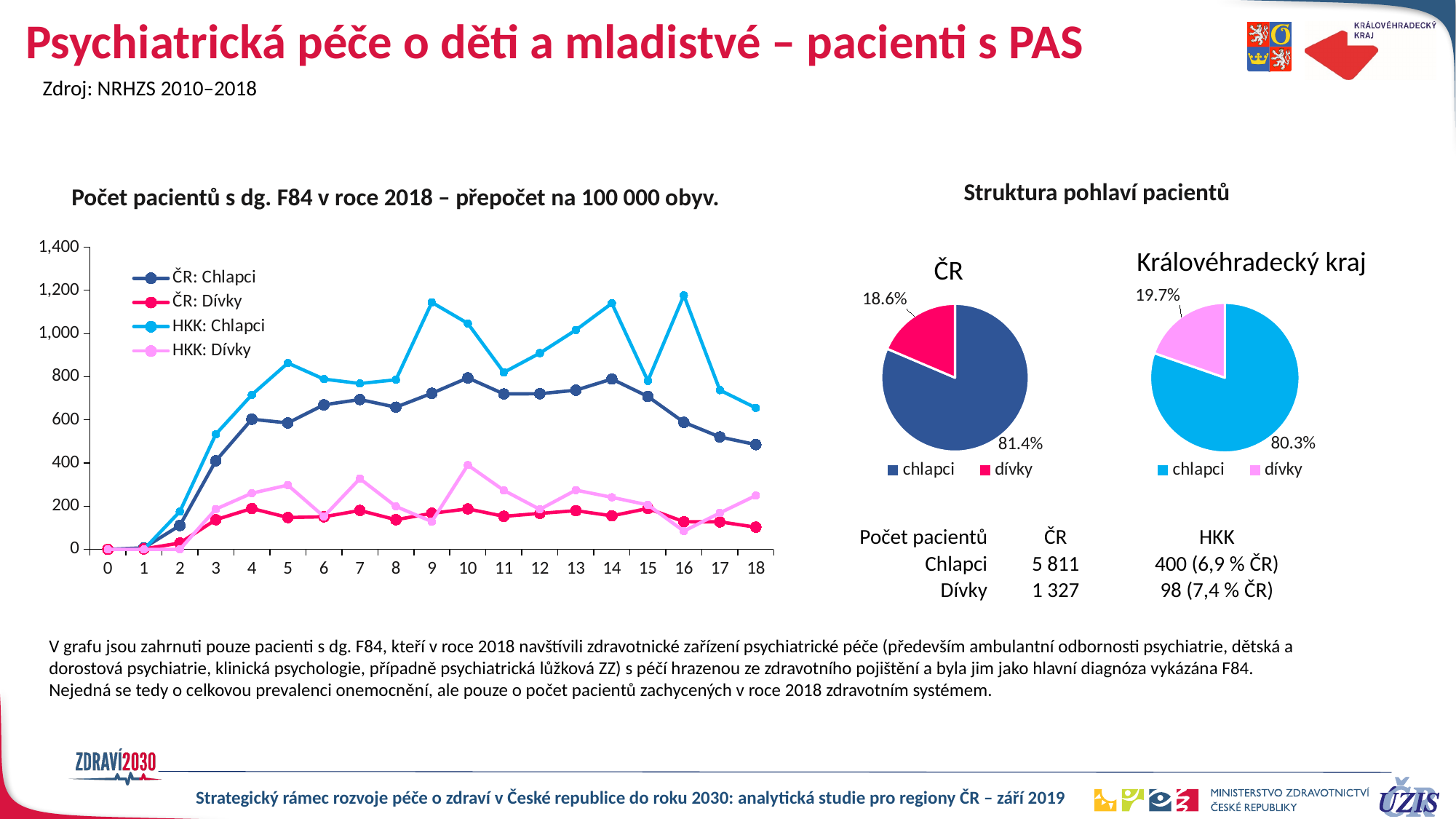
In the line chart 'Počet pacientů s dg. F84 v roce 2018', does the ČR: Chlapci series rise or fall between 14 and 18? fall In the line chart 'Počet pacientů s dg. F84 v roce 2018', which series reaches the highest value? HKK: Chlapci In the pie chart 'ČR', what is the difference in percentage points between the chlapci and dívky shares? 62.8 How many points are on the x axis of the line chart 'Počet pacientů s dg. F84 v roce 2018'? 19 In the line chart 'Počet pacientů s dg. F84 v roce 2018', is the value for ČR: Dívky at 18 greater or less than 200? less In the line chart 'Počet pacientů s dg. F84 v roce 2018', at 9 which is larger: HKK: Chlapci or ČR: Chlapci? HKK: Chlapci How many series does the legend of the line chart 'Počet pacientů s dg. F84 v roce 2018' list? 4 In the pie chart 'Královéhradecký kraj', what share is chlapci? 80.3% Is the dívky share larger in the 'ČR' pie chart or in the 'Královéhradecký kraj' pie chart? Královéhradecký kraj In the pie chart 'ČR', what share is dívky? 18.6% In the line chart 'Počet pacientů s dg. F84 v roce 2018', is the value for HKK: Chlapci at 16 greater or less than 1,000? greater What kind of chart is the chart titled 'Počet pacientů s dg. F84 v roce 2018 – přepočet na 100 000 obyv.'? line chart